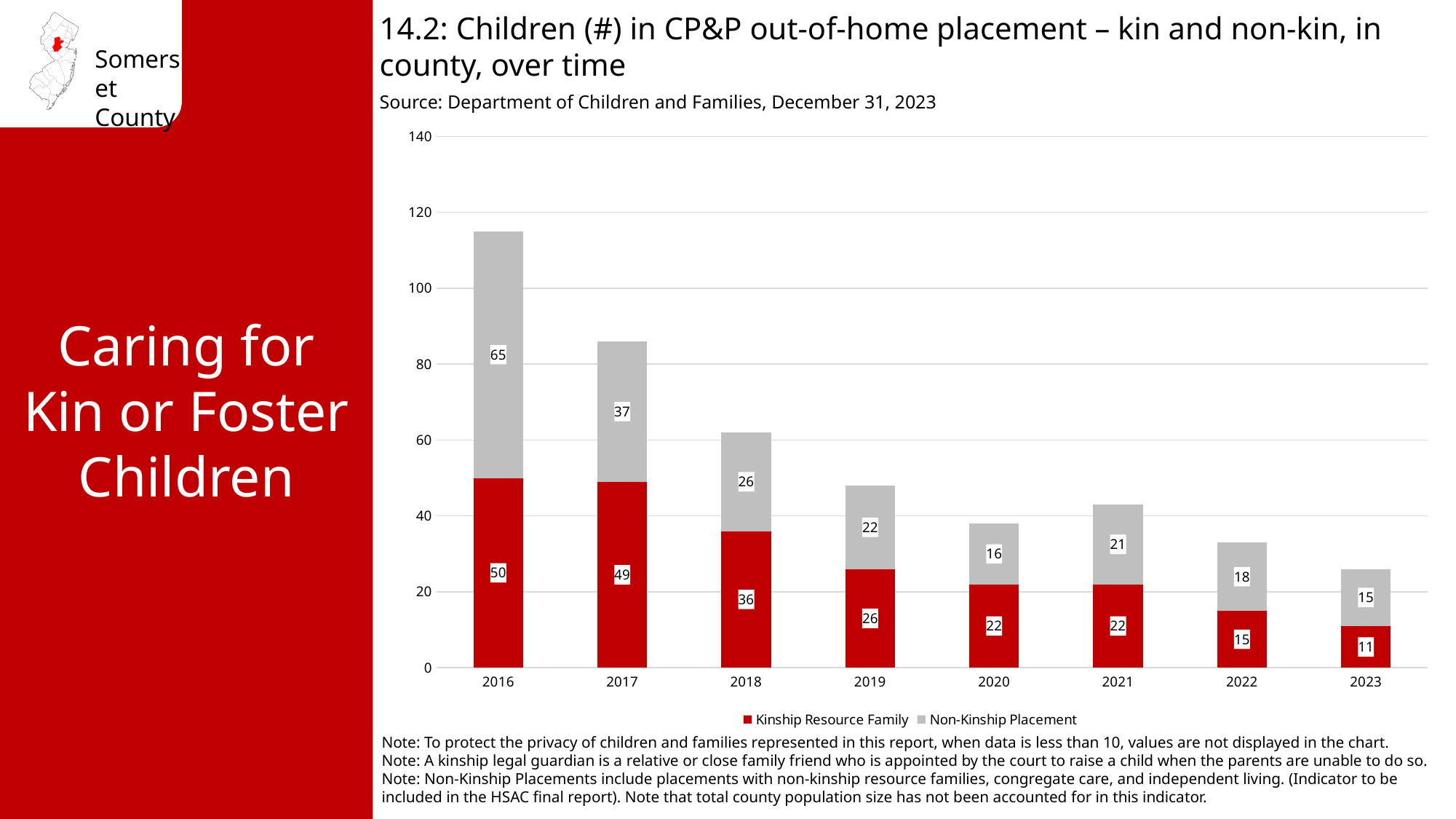
In 2022, which is larger: Kinship Resource Family or Non-Kinship Placement? Non-Kinship Placement What is the difference between the Kinship Resource Family values for 2016 and 2017? 1 Do the total bar heights generally rise or fall from 2016 to 2023? Fall What is the Non-Kinship Placement value for 2021? 21 What is the Kinship Resource Family value for 2018? 36 What is the total number of children in out-of-home placement in 2016 (both segments combined)? 115 What is the total of the stacked bar for 2023? 26 Which year has the highest Non-Kinship Placement value? 2016 Which year has the lowest Kinship Resource Family value? 2023 How many series does the legend list? 2 How many years are shown on the x axis? 8 What type of chart is shown on the slide? Stacked bar chart